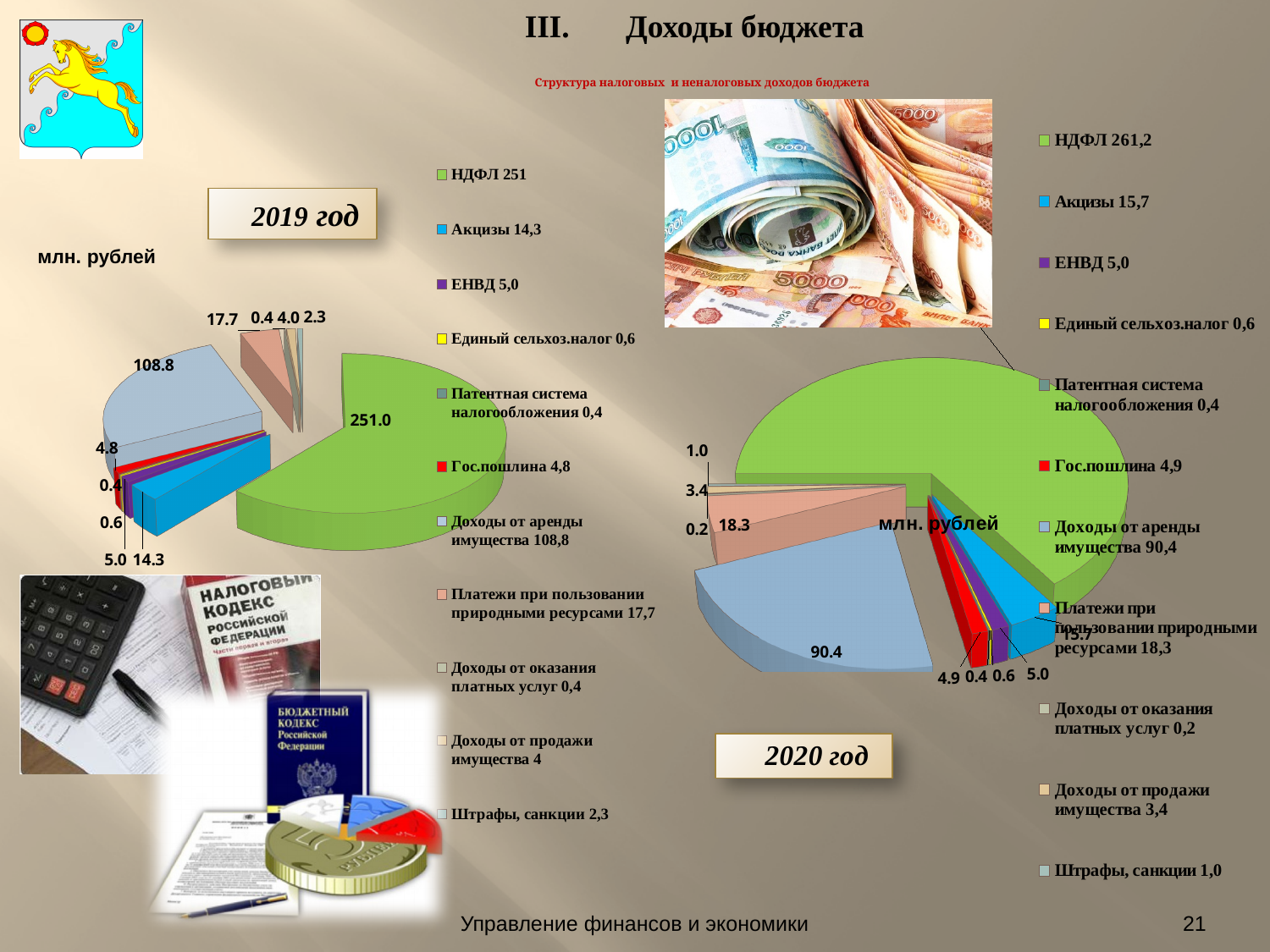
In the 2019 год chart, what is the value for НДФЛ? 251 In the 2020 год chart, what is the value for Доходы от аренды имущества? 90,4 In the 2020 год chart, which category has the smallest value? Доходы от оказания платных услуг How many categories does the legend of the 2020 год chart list? 11 In the 2020 год chart, what is the difference between НДФЛ and Доходы от аренды имущества? 170,8 In the 2020 год chart, which category has the largest value? НДФЛ What unit is shown next to the 2019 год chart? млн. рублей What type of chart is used for the 2019 год chart on the left? Pie chart In the 2019 год chart, what is the difference between НДФЛ and Доходы от аренды имущества? 142,2 Which is larger: Акцизы in the 2019 год chart or Акцизы in the 2020 год chart? 2020 год In the 2019 год chart, what is the value for Акцизы? 14,3 In the 2020 год chart, what is the value for Платежи при пользовании природными ресурсами? 18,3